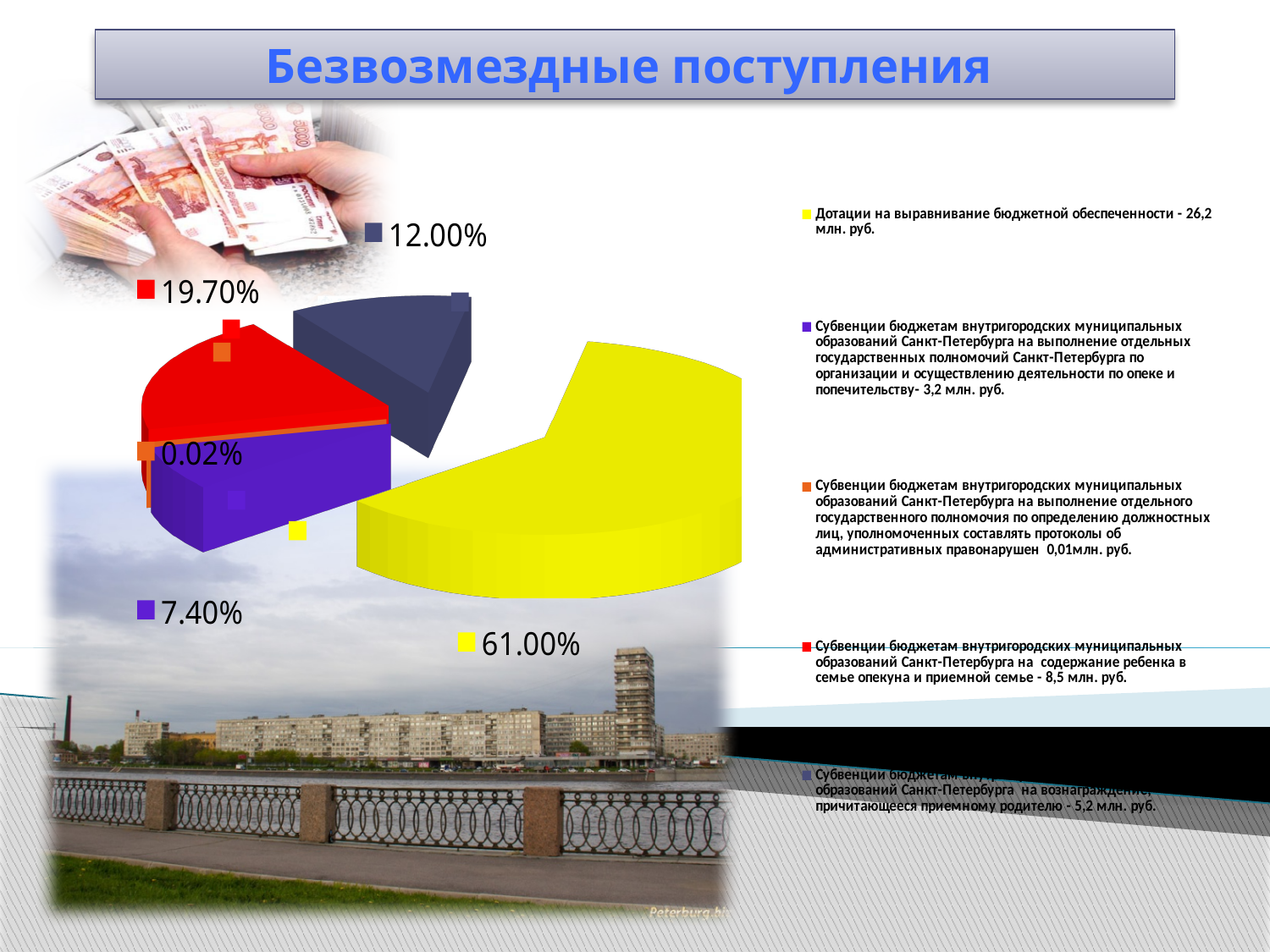
What percentage is shown for the dark blue slice (Субвенции на вознаграждение, причитающееся приемному родителю)? 12.00% What is the smallest percentage shown on the pie chart? 0.02% What percentage is shown for the purple slice (Субвенции на выполнение полномочий по опеке и попечительству)? 7.40% What percentage is shown for the yellow slice (Дотации на выравнивание бюджетной обеспеченности)? 61.00% What is the title of the slide containing the pie chart? Безвозмездные поступления What is the largest percentage shown on the pie chart? 61.00% What percentage is shown for the red slice (Субвенции на содержание ребенка в семье опекуна и приемной семье)? 19.70% Which slice is larger: the dark blue slice at 12.00% or the purple slice at 7.40%? the dark blue slice (12.00%) What is the difference in percentage points between the 61.00% slice and the 19.70% slice? 41.30% What kind of chart is shown on the slide? pie chart How many slices does the pie chart have? 5 According to the legend, what amount in млн. руб. corresponds to Дотации на выравнивание бюджетной обеспеченности? 26,2 млн. руб.